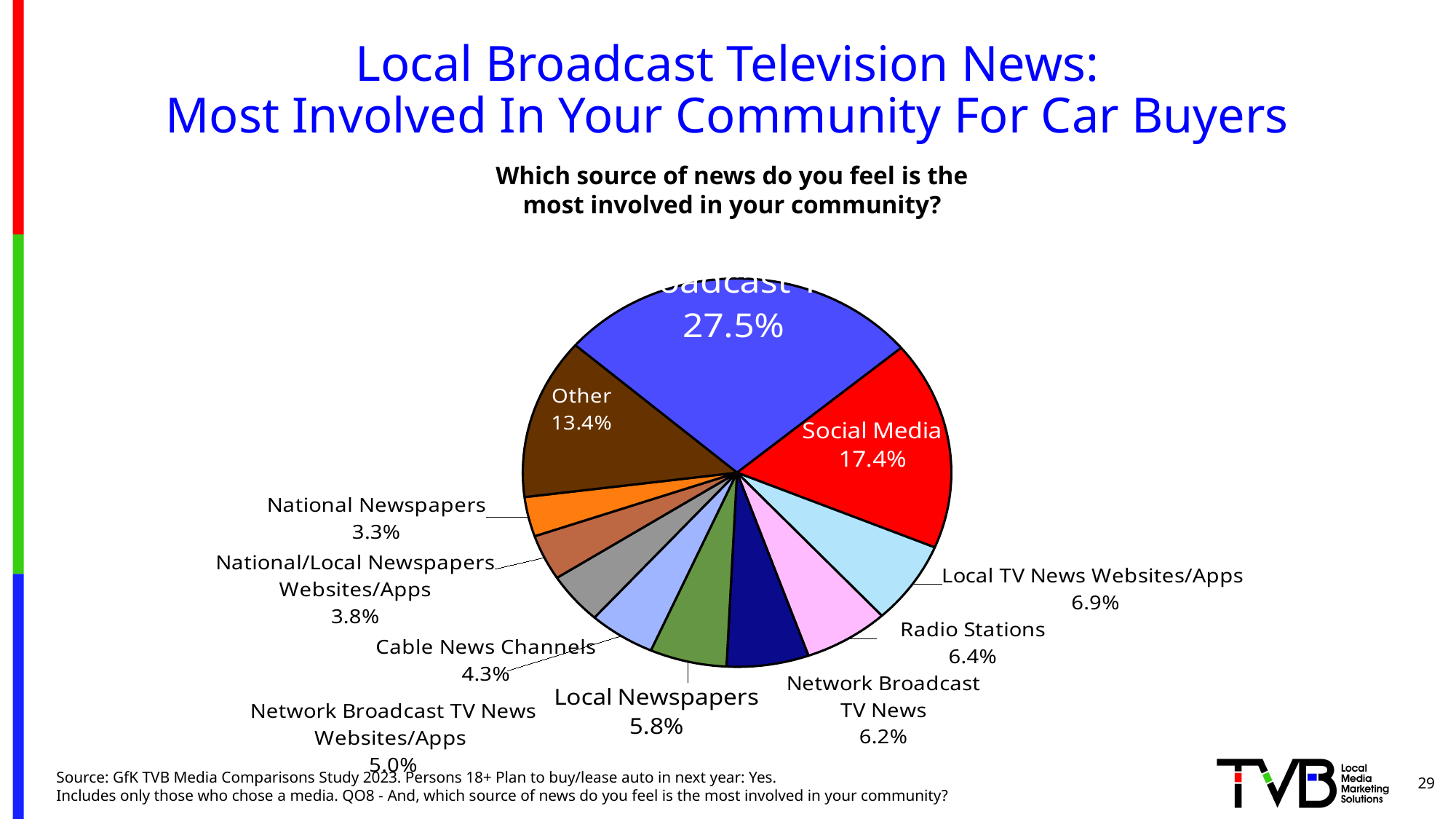
Which is larger, Local Newspapers or Network Broadcast TV News? Network Broadcast TV News What is the value shown for Cable News Channels? 4.3% What is the value shown for Radio Stations? 6.4% What percentage is shown on the largest slice of the pie? 27.5% What is the value shown for Network Broadcast TV News Websites/Apps? 5.0% What is the value shown for Local TV News Websites/Apps? 6.9% What kind of chart is shown on the slide? pie chart How many slices does the pie chart have? 11 What is the value shown for Other? 13.4% What is the difference between Social Media and Other? 4.0% What share of the pie does Social Media have? 17.4% Which labelled category has the smallest slice of the pie? National Newspapers